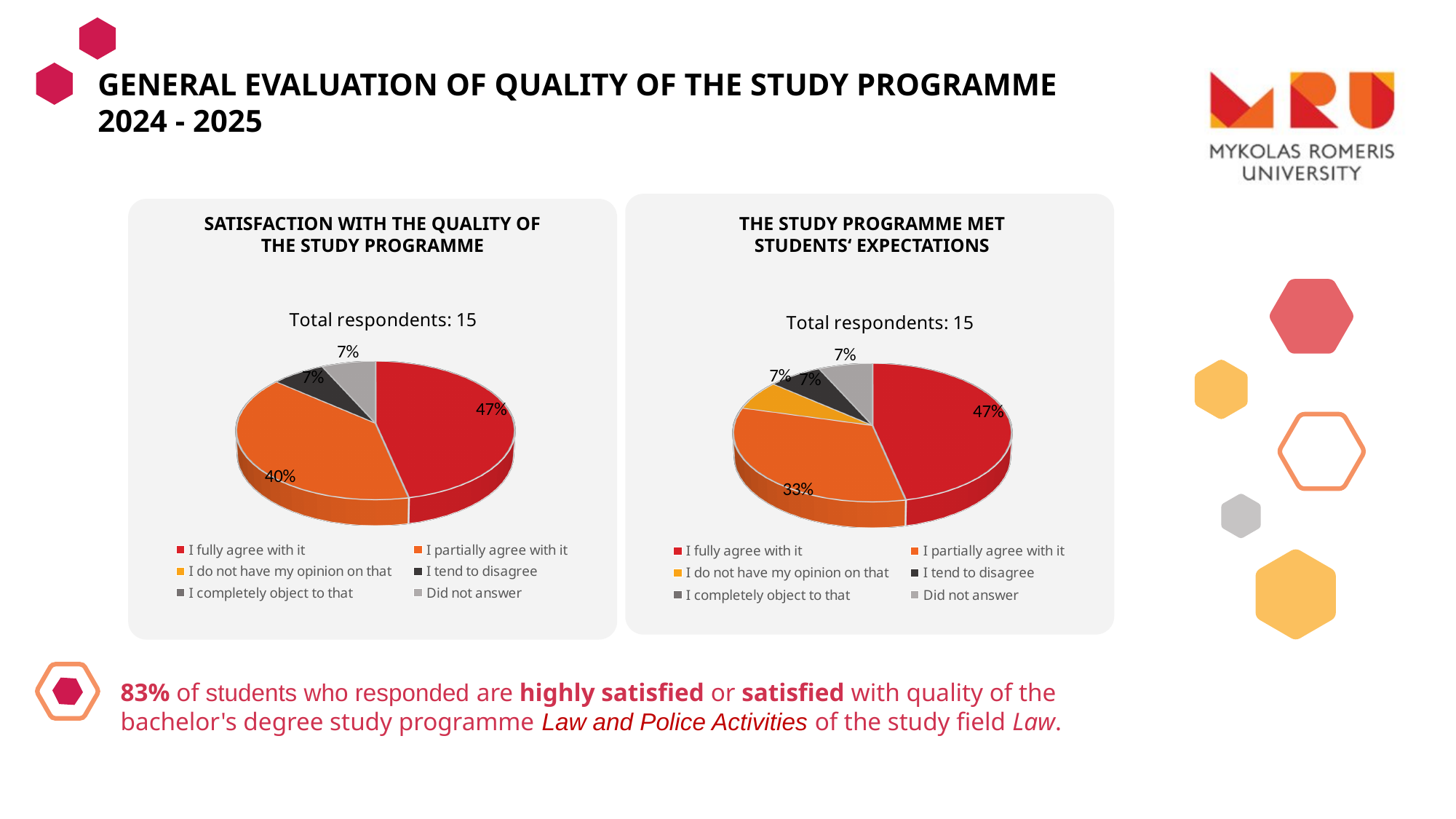
How many slices does the pie chart titled 'The study programme met students' expectations' have? 5 In the chart titled 'Satisfaction with the quality of the study programme', what is the difference between the 'I fully agree with it' and 'I partially agree with it' shares? 7% In the chart titled 'Satisfaction with the quality of the study programme', what share of respondents chose 'I partially agree with it'? 40% In the chart titled 'The study programme met students' expectations', what is the difference between the 'I fully agree with it' and 'I partially agree with it' shares? 14% In the chart titled 'Satisfaction with the quality of the study programme', what share of respondents chose 'I fully agree with it'? 47% Which chart has the larger 'I partially agree with it' share: the left chart or the right chart? The left chart In the chart titled 'The study programme met students' expectations', what share of respondents chose 'I partially agree with it'? 33% What type of chart is used in the chart titled 'Satisfaction with the quality of the study programme'? Pie chart How many entries does the legend of the chart titled 'Satisfaction with the quality of the study programme' list? 6 In the chart titled 'Satisfaction with the quality of the study programme', which response has the largest slice? I fully agree with it In the chart titled 'The study programme met students' expectations', which response has the largest slice? I fully agree with it In the chart titled 'The study programme met students' expectations', what share of respondents chose 'I do not have my opinion on that'? 7%